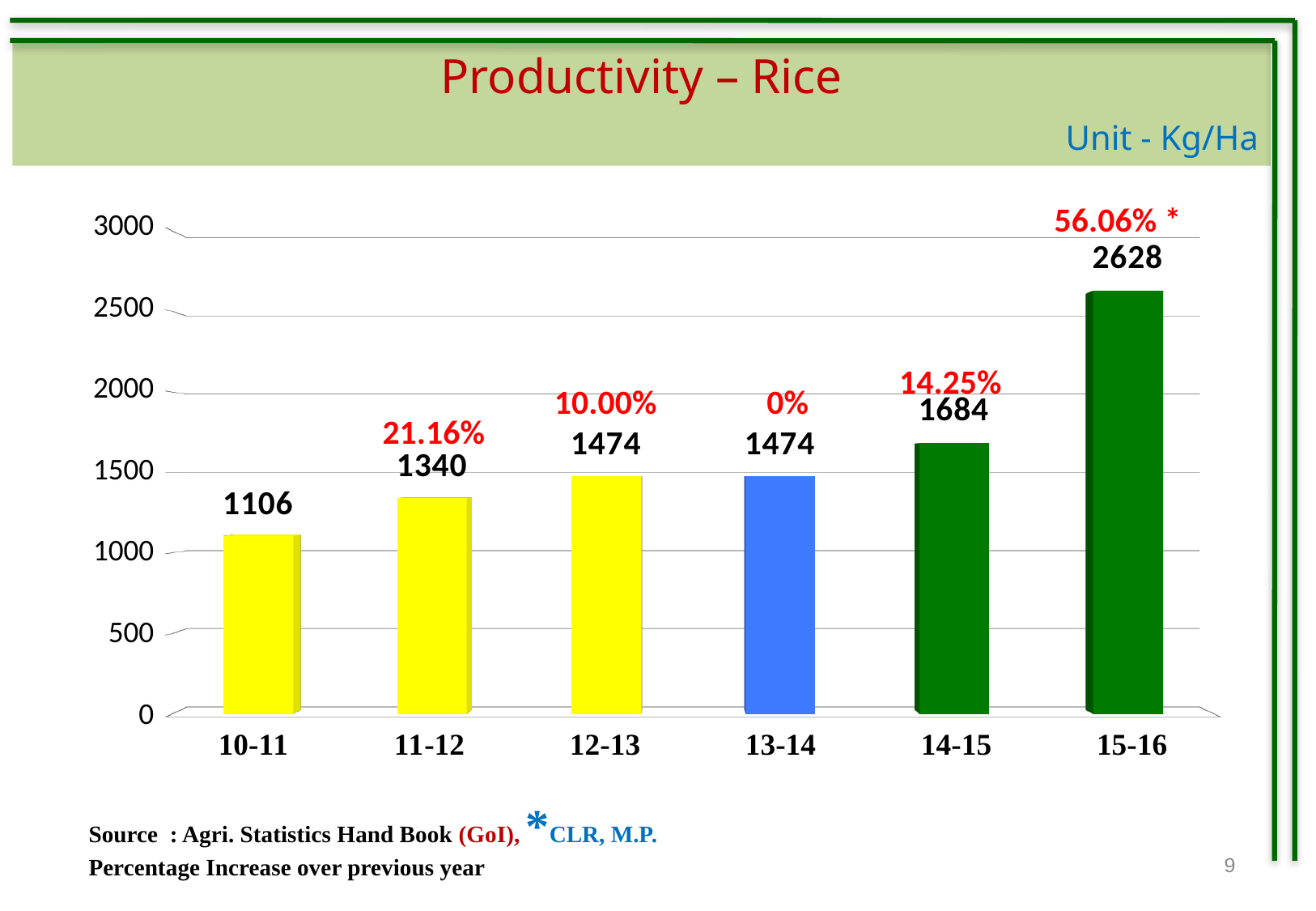
What is the percentage increase over the previous year shown for 15-16? 56.06% What is the difference in rice productivity between 11-12 and 10-11? 234 What is the difference in rice productivity between 15-16 and 14-15? 944 Which is larger, the rice productivity for 12-13 or for 14-15? 14-15 What is the rice productivity value for 14-15? 1684 Which year has the lowest rice productivity? 10-11 What is the rice productivity value for 15-16? 2628 How many years are shown on the chart? 6 What is the rice productivity value for 10-11? 1106 What kind of chart is shown on the slide? bar chart Which year has the highest rice productivity? 15-16 What unit is the rice productivity measured in? Kg/Ha